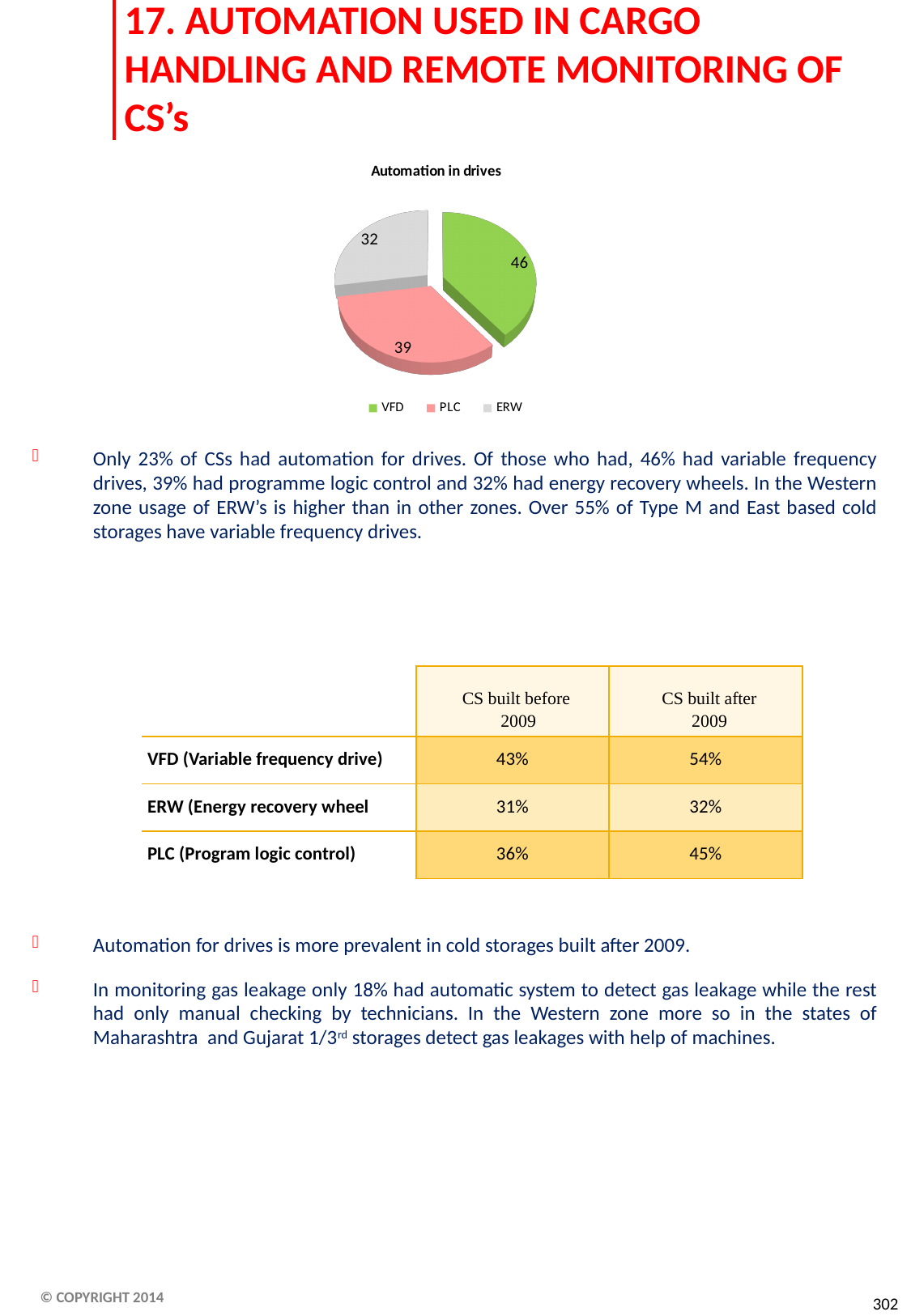
How many entries does the legend of the Automation in drives chart list? 3 What is the value shown for VFD in the Automation in drives pie chart? 46 What is the value shown for PLC in the Automation in drives pie chart? 39 What colour is the VFD slice in the Automation in drives pie chart? Green What type of chart is used to show Automation in drives? Pie chart Which category has the largest slice in the Automation in drives pie chart? VFD In the Automation in drives pie chart, which is larger, PLC or ERW? PLC Which category has the smallest slice in the Automation in drives pie chart? ERW What is the difference between the VFD and PLC values in the Automation in drives pie chart? 7 What is the value shown for ERW in the Automation in drives pie chart? 32 What is the difference between the VFD and ERW values in the Automation in drives pie chart? 14 How many slices does the Automation in drives pie chart have? 3